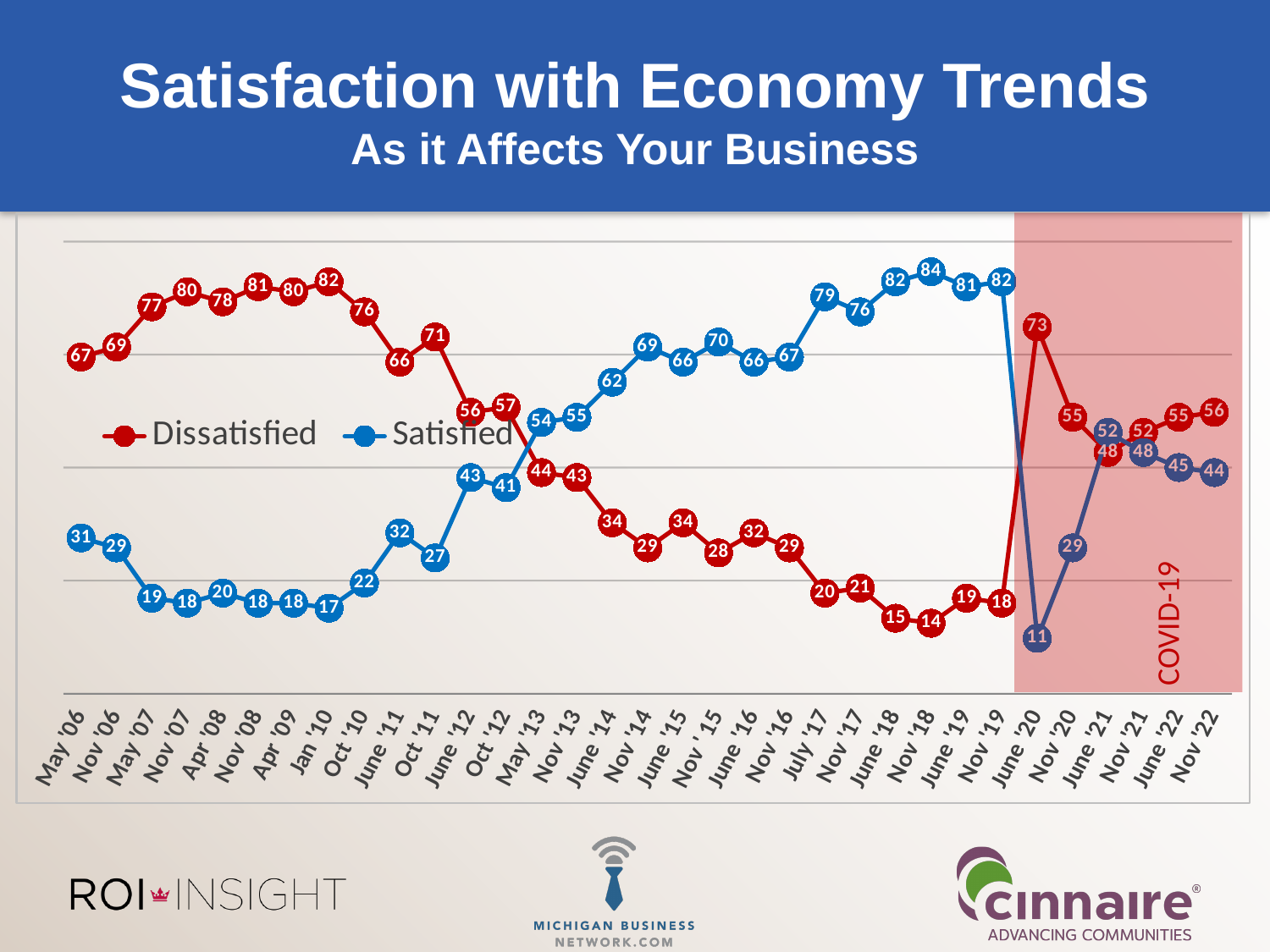
Which series has the larger value at Nov '22, Dissatisfied or Satisfied? Dissatisfied What kind of chart is shown on the slide? Line chart At which date does the Dissatisfied series reach its lowest value? Nov '18 What is the difference between the Dissatisfied and Satisfied values at June '20? 62 What is the Dissatisfied value for May '06? 67 Does the Satisfied series rise or fall between Oct '11 and Nov '18? Rise What is the Dissatisfied value for June '20? 73 At which date does the Satisfied series reach its highest value? Nov '18 What label is written in the shaded region on the right side of the chart? COVID-19 What is the Satisfied value for June '20? 11 What is the Satisfied value for Nov '22? 44 How many series does the legend list? 2